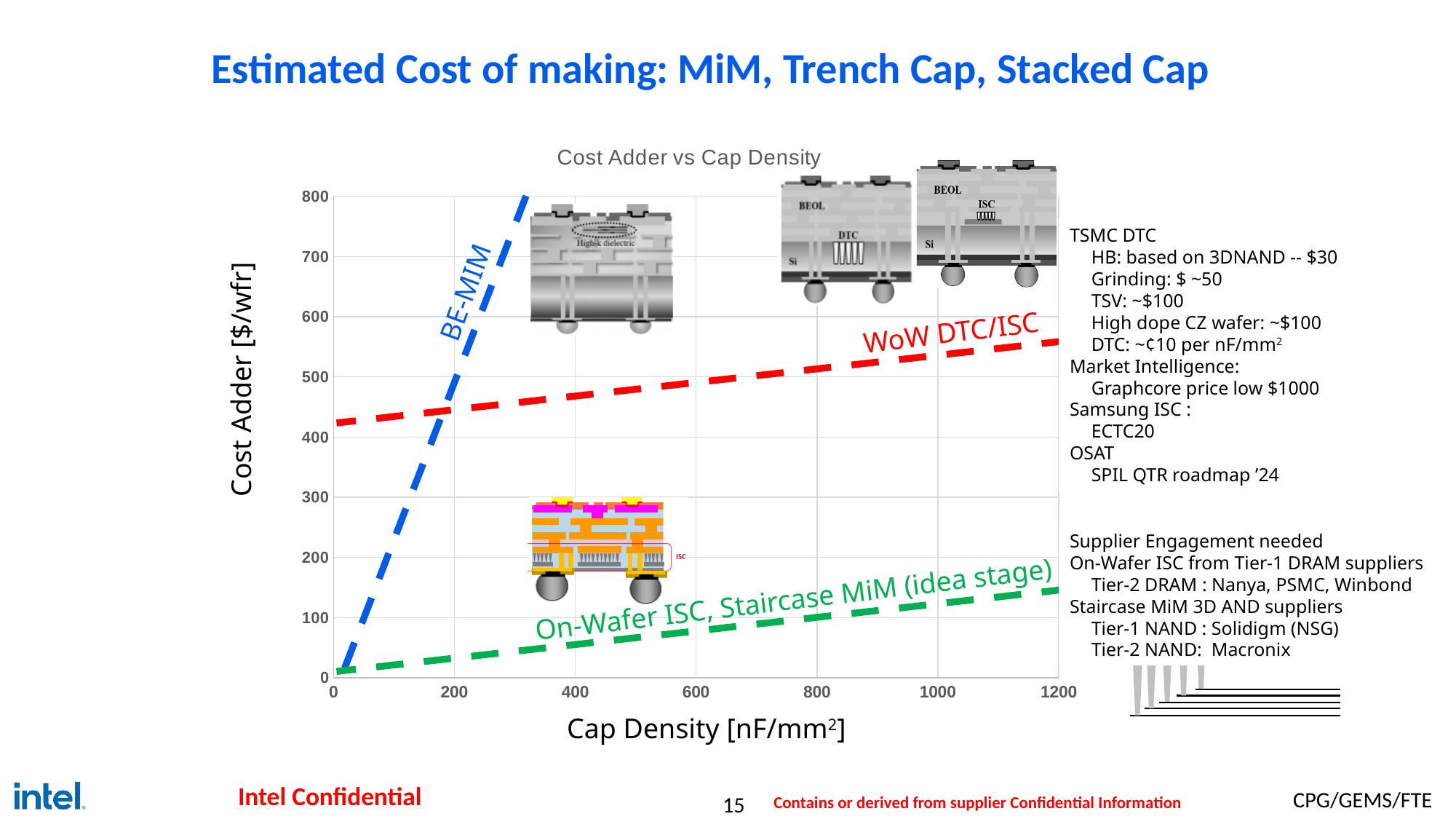
How many lines (series) are plotted on the chart? 3 At a Cap Density of 600, which line has the higher Cost Adder: WoW DTC/ISC or On-Wafer ISC, Staircase MiM? WoW DTC/ISC Is the value of the On-Wafer ISC, Staircase MiM line at a Cap Density of 1200 greater or less than 200? less Is the value of the WoW DTC/ISC line at a Cap Density of 0 greater or less than 400? greater Is the value of the WoW DTC/ISC line at a Cap Density of 1200 greater or less than 500? greater Does the BE-MIM line rise or fall as Cap Density increases? rise Does the WoW DTC/ISC line rise or fall as Cap Density increases? rise Which line reaches the highest Cost Adder value on the chart? BE-MIM What kind of chart is shown on the slide? line chart What is the title of the chart? Cost Adder vs Cap Density What is the label of the y axis? Cost Adder [$/wfr]